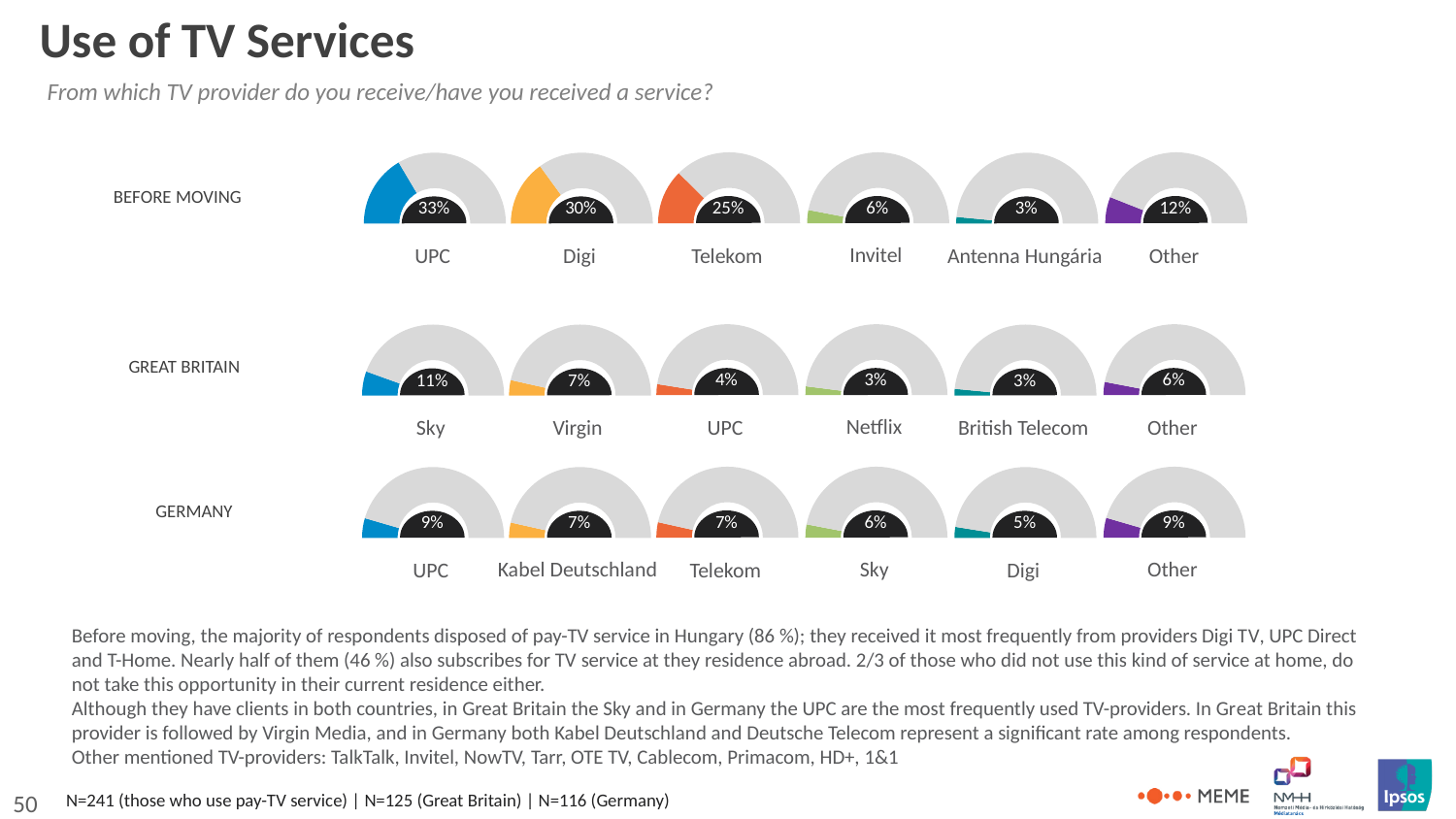
In the Before Moving row, which provider has the lowest percentage? Antenna Hungária In the Before Moving row, what percentage is shown for Invitel? 6% In the Great Britain row, what is the difference between the percentages for Sky and Virgin? 4% In the Germany row, what percentage is shown for Kabel Deutschland? 7% In the Great Britain row, which provider has the highest percentage? Sky In the Before Moving row, which provider has the highest percentage? UPC How many providers are shown in the Germany row? 6 What is the title of the slide containing these charts? Use of TV Services In the Before Moving row, what percentage is shown for UPC? 33% In the Great Britain row, what percentage is shown for Sky? 11% In the Before Moving row, what is the difference between the percentages for UPC and Telekom? 8% In the Germany row, which is larger, the percentage for UPC or the percentage for Digi? UPC